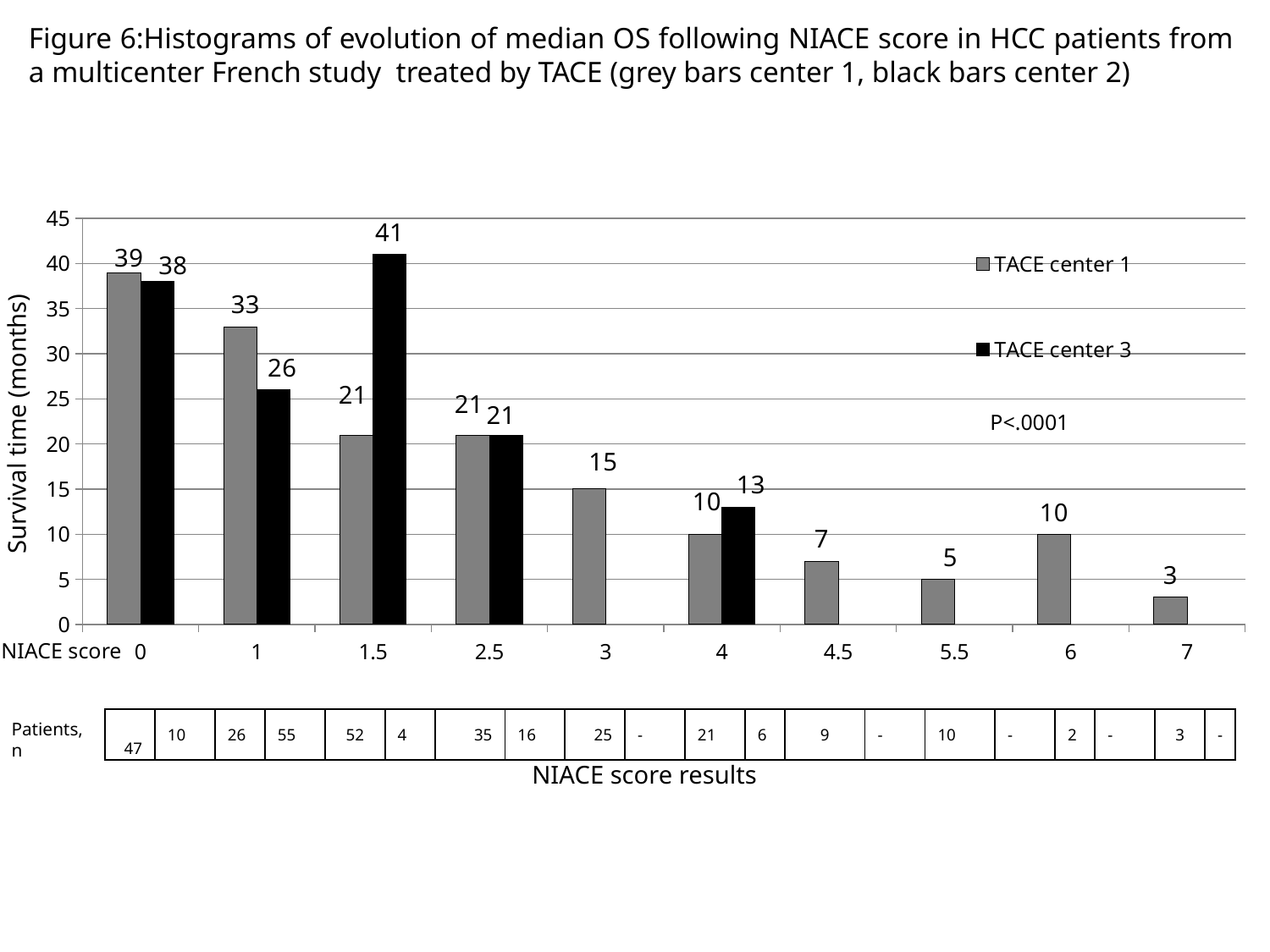
What is the difference between the TACE center 1 and TACE center 3 survival times at NIACE score 1? 7 Do the TACE center 1 survival times generally rise or fall as the NIACE score increases? fall At NIACE score 1.5, which series has the larger survival time, TACE center 1 or TACE center 3? TACE center 3 What kind of chart is shown on the slide? bar chart What is the label of the y axis? Survival time (months) Which NIACE score has the highest survival time for TACE center 3? 1.5 How many NIACE score categories are shown on the x axis? 10 How many series does the legend list? 2 What is the survival time for TACE center 1 at NIACE score 0? 39 What is the survival time for TACE center 3 at NIACE score 1.5? 41 Which NIACE score has the lowest survival time for TACE center 1? 7 What is the survival time for TACE center 1 at NIACE score 4.5? 7